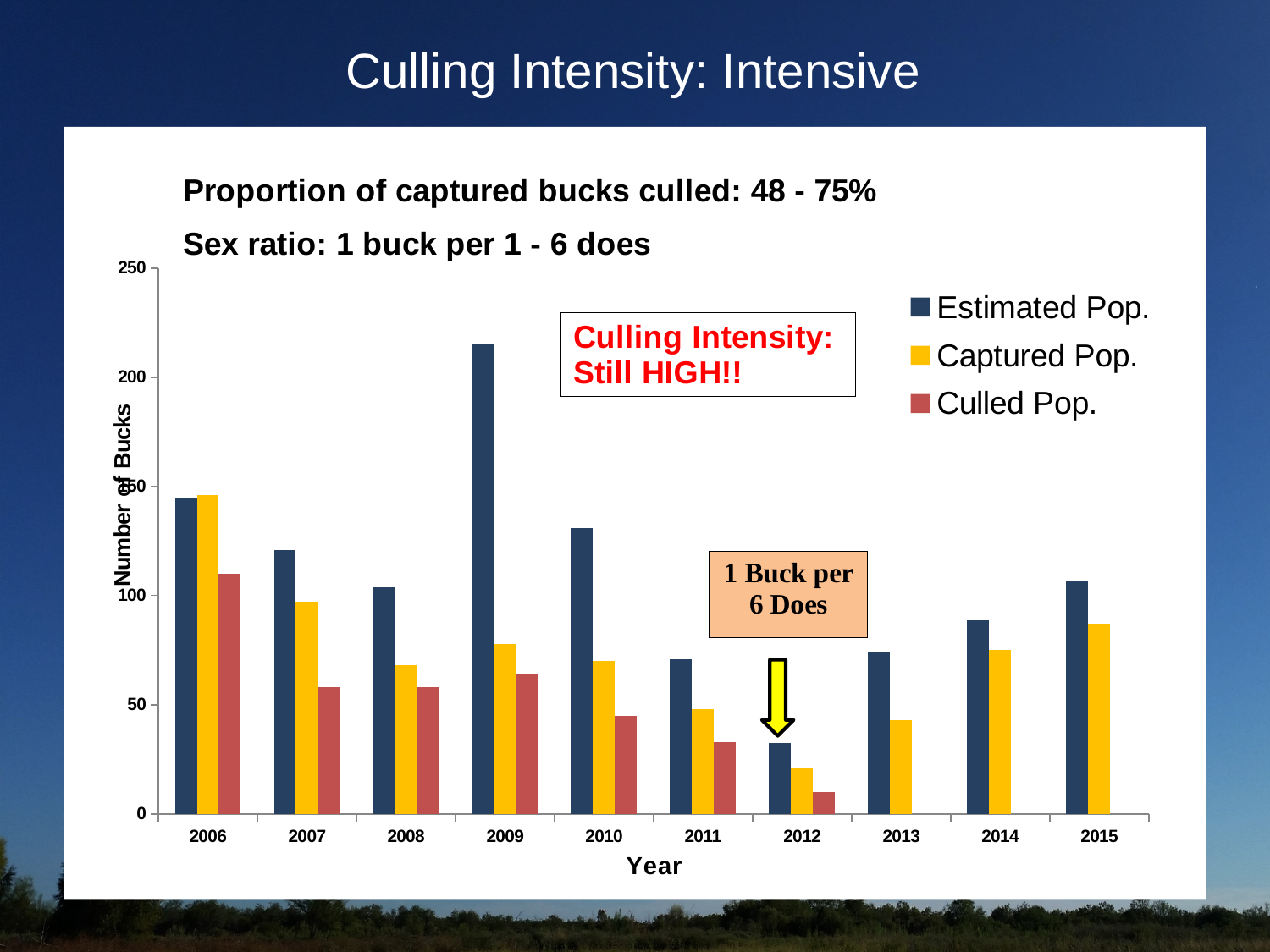
Is the Estimated Pop. value for 2009 greater or less than 200? greater Does the Estimated Pop. rise or fall from 2012 to 2015? rise How many years are shown on the x axis? 10 In which year is the Estimated Pop. lowest? 2012 In which year is the Culled Pop. highest? 2006 In which year is the Estimated Pop. highest? 2009 Is the Captured Pop. value for 2012 greater or less than 50? less What is the title of the x axis? Year How many series does the legend list? 3 Which is larger, the Estimated Pop. for 2010 or for 2008? 2010 Is the Culled Pop. value for 2006 greater or less than 100? greater What kind of chart is shown on the slide? bar chart